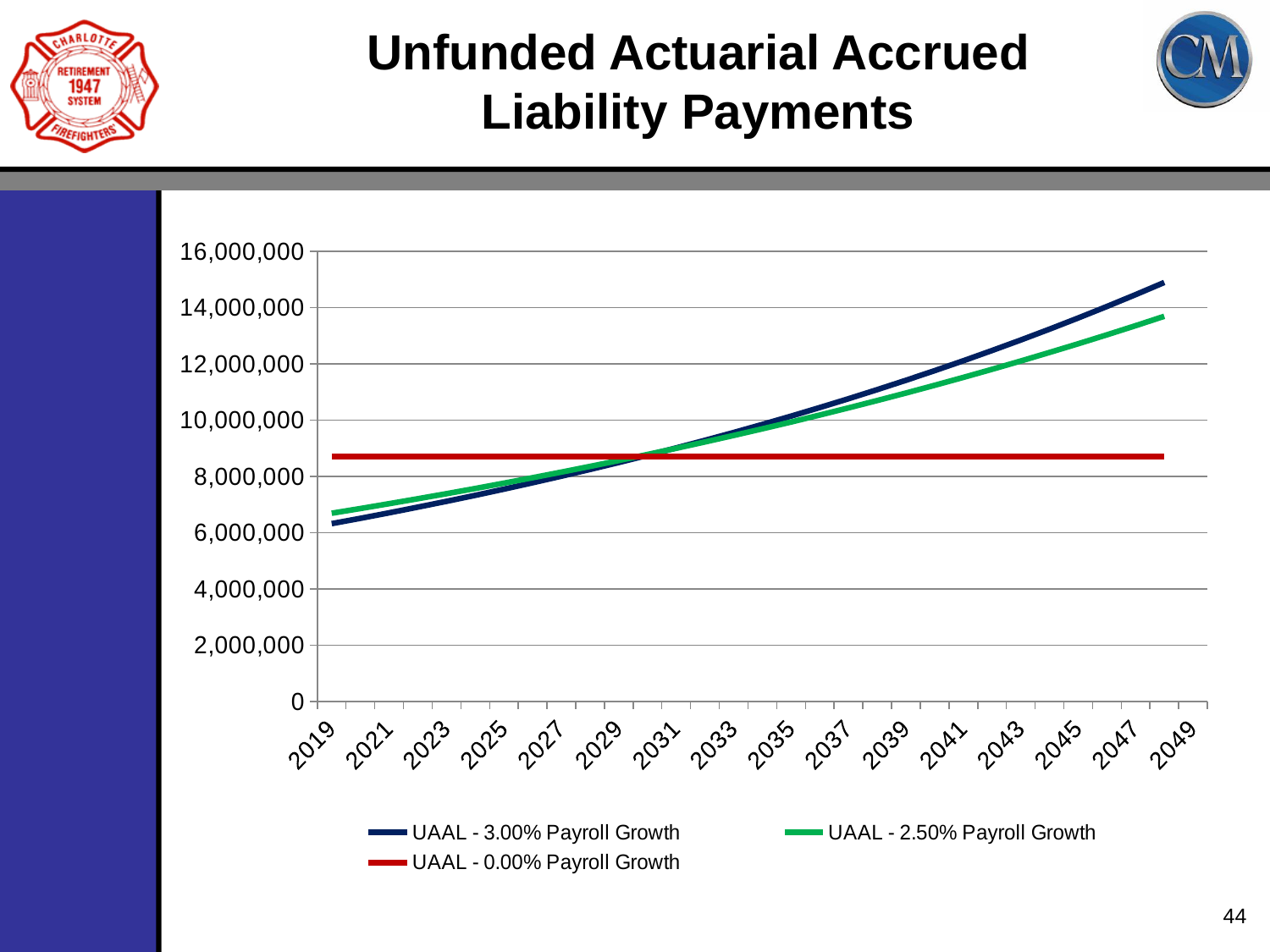
What kind of chart is shown on the slide? line chart Is the value for UAAL - 2.50% Payroll Growth in 2019 greater or less than 8,000,000? less Does the UAAL - 3.00% Payroll Growth line rise or fall from 2019 to 2049? rise What is the title of the chart? Unfunded Actuarial Accrued Liability Payments Is the value for UAAL - 0.00% Payroll Growth in 2035 greater or less than 10,000,000? less How many series does the legend list? 3 Is the value for UAAL - 0.00% Payroll Growth in 2035 greater or less than 8,000,000? greater What colour is the line for UAAL - 0.00% Payroll Growth? red In 2019, which series is higher: UAAL - 3.00% Payroll Growth or UAAL - 2.50% Payroll Growth? UAAL - 2.50% Payroll Growth